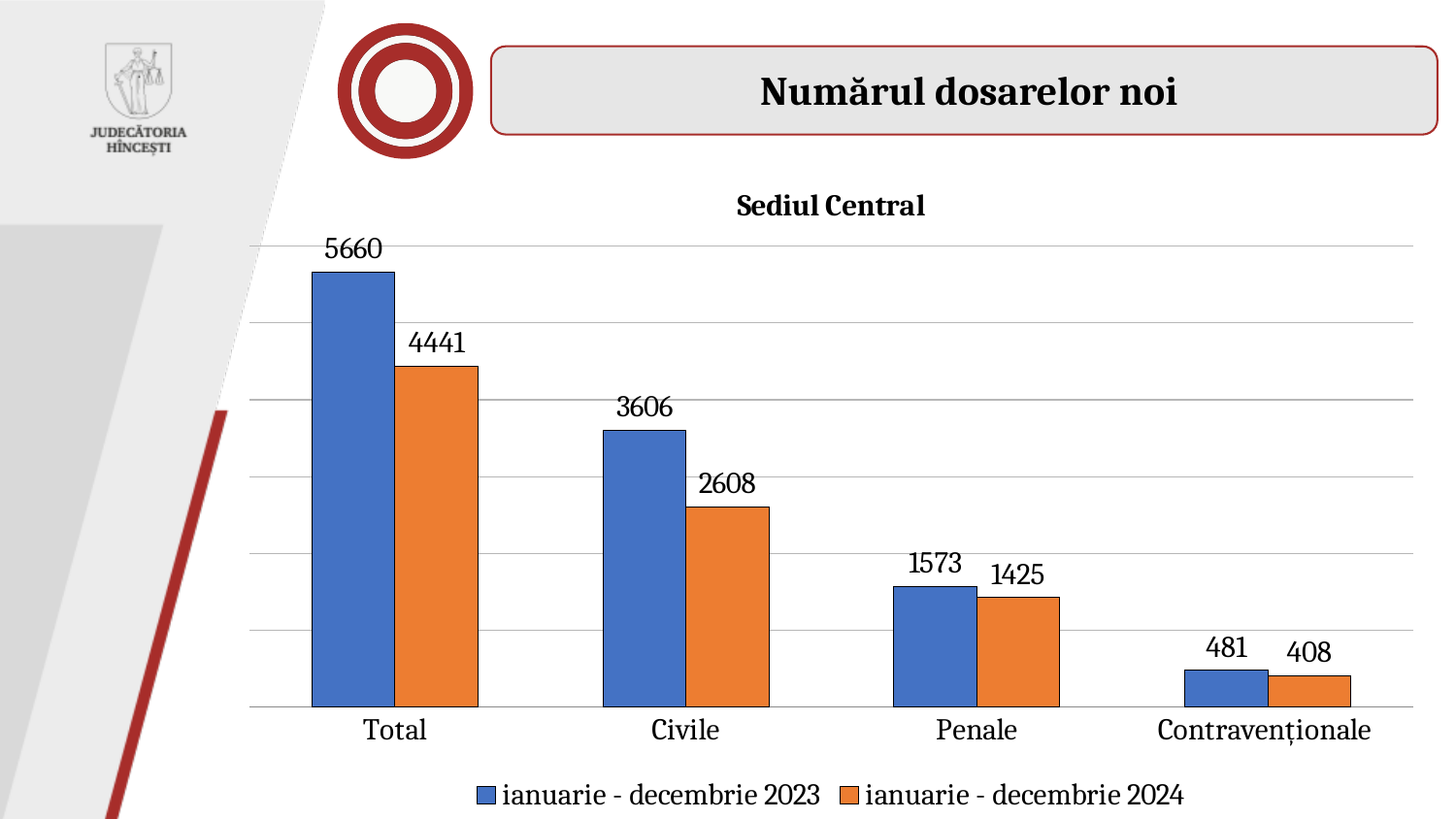
What is the value for Civile in the ianuarie - decembrie 2023 series? 3606 What is the difference between the Civile values for 2023 and 2024? 998 What is the value for Contravenționale in the ianuarie - decembrie 2023 series? 481 What is the value for Penale in the ianuarie - decembrie 2024 series? 1425 What is the difference between the Total values for 2023 and 2024? 1219 Which category has the lowest value in the ianuarie - decembrie 2024 series? Contravenționale How many categories are shown on the x axis? 4 Which is larger for Penale: the 2023 value or the 2024 value? 2023 value (1573) What is the Total value for ianuarie - decembrie 2024? 4441 Which category has the highest value in the ianuarie - decembrie 2023 series? Total How many series does the legend list? 2 What type of chart is shown on the slide? Bar chart